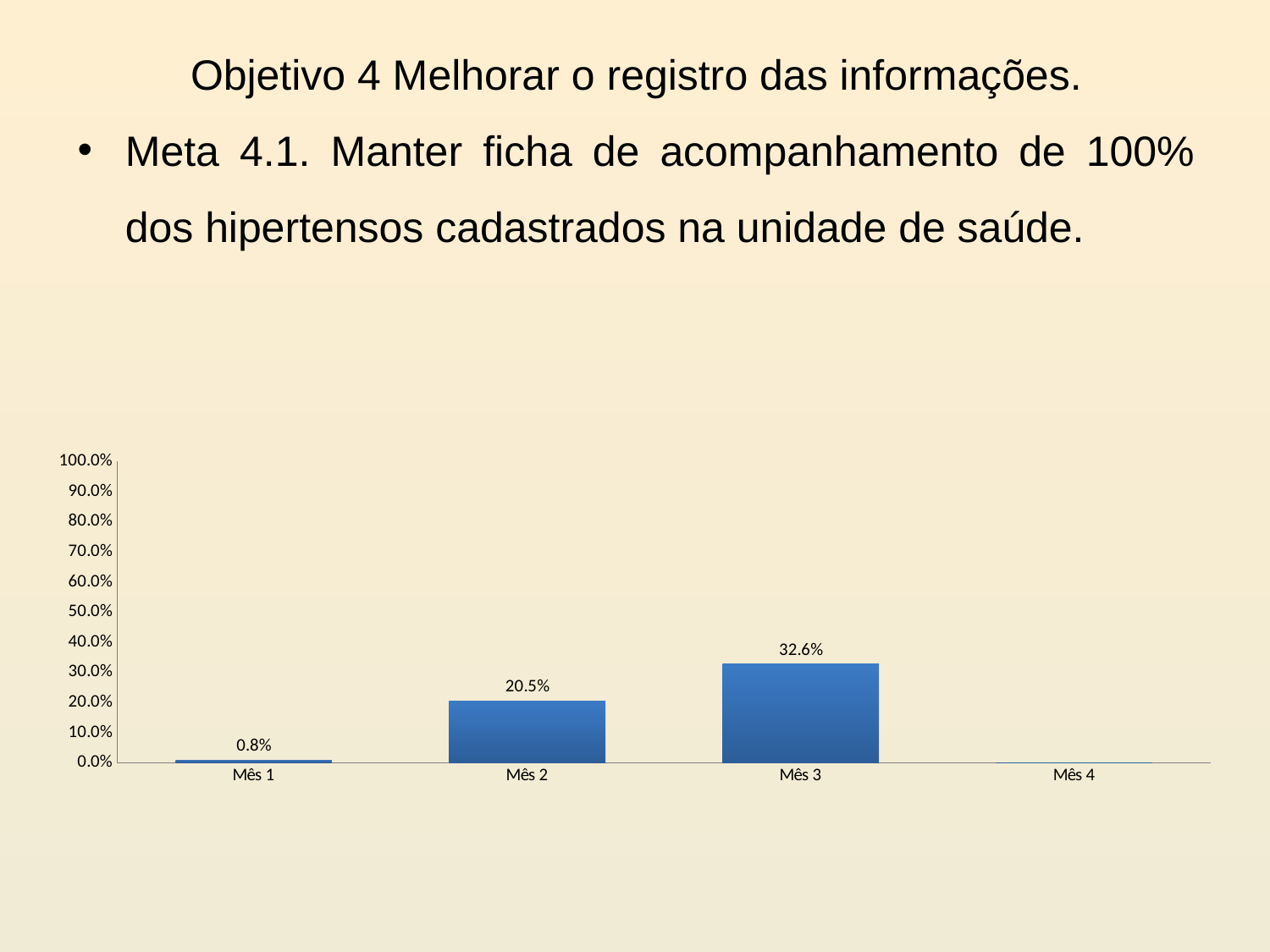
How many categories are shown on the x axis? 4 What kind of chart is shown on the slide? bar chart What is the value for Mês 1? 0.8% What is the value for Mês 3? 32.6% Is the value for Mês 2 greater or less than 30.0%? less Which month has the highest value? Mês 3 Which is larger, the value for Mês 2 or the value for Mês 3? Mês 3 What is the difference between the values for Mês 3 and Mês 2? 12.1% Is the value for Mês 3 greater or less than 30.0%? greater What is the value for Mês 2? 20.5% What is the difference between the values for Mês 2 and Mês 1? 19.7% Do the values rise or fall from Mês 1 to Mês 3? rise